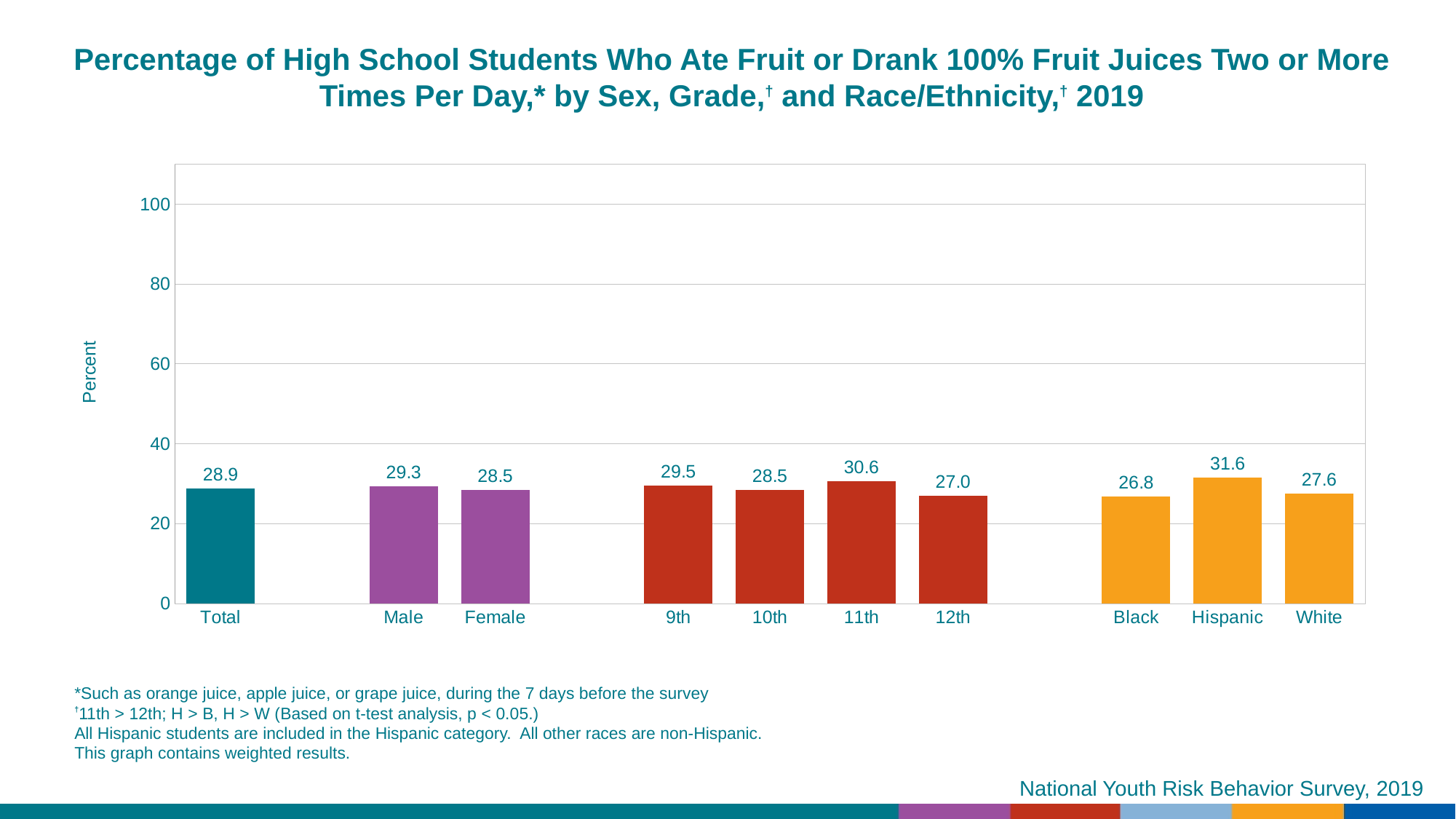
What is the difference between the values for Male and Female? 0.8 What percentage of Hispanic students ate fruit or drank 100% fruit juices two or more times per day? 31.6 What is the value for 12th grade students? 27.0 Which category has the lowest value? Black What kind of chart is this? bar chart What is the value for Total? 28.9 What is the label on the y axis? Percent How many categories are shown on the x axis? 10 What is the difference between the values for 11th and 12th grade? 3.6 Which is larger, the value for Hispanic or the value for White? Hispanic Which category has the highest value? Hispanic Is the value for 9th grade greater or less than 40? less